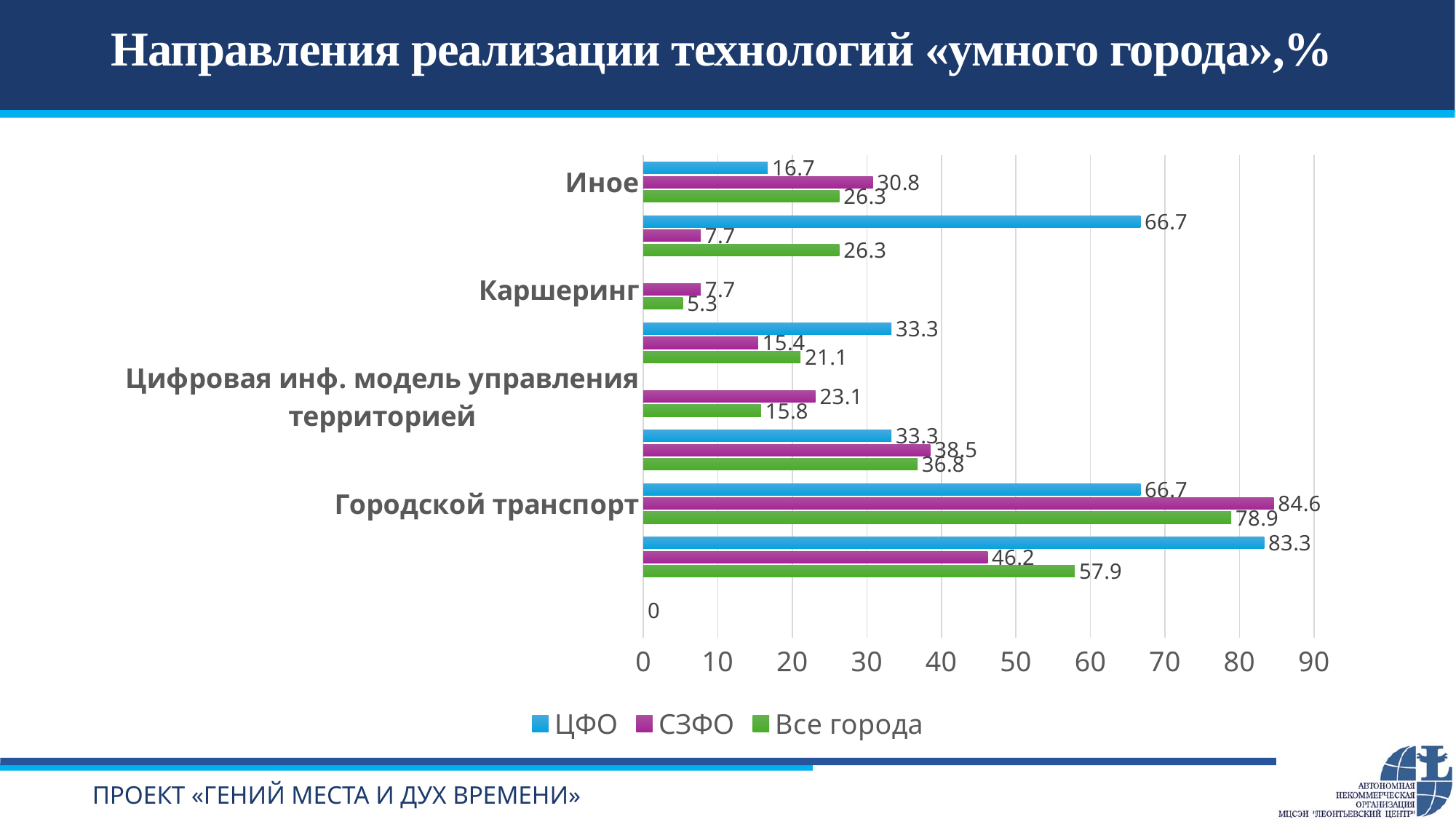
What is the value for СЗФО in the Цифровая инф. модель управления территорией category? 23.1 What is the value for СЗФО in the Городской транспорт category? 84.6 What is the difference between the СЗФО and ЦФО values in the Иное category? 14.1 Which series has the highest value in the Городской транспорт category? СЗФО What is the value for Все города in the Каршеринг category? 5.3 What is the title of the chart? Направления реализации технологий «умного города»,% What is the value for Все города in the Городской транспорт category? 78.9 What kind of chart is shown on the slide? Bar chart How many series does the legend list? 3 Which series has the lowest value in the Иное category? ЦФО What is the value for ЦФО in the Иное category? 16.7 Which is larger in the Городской транспорт category: the ЦФО value or the Все города value? Все города